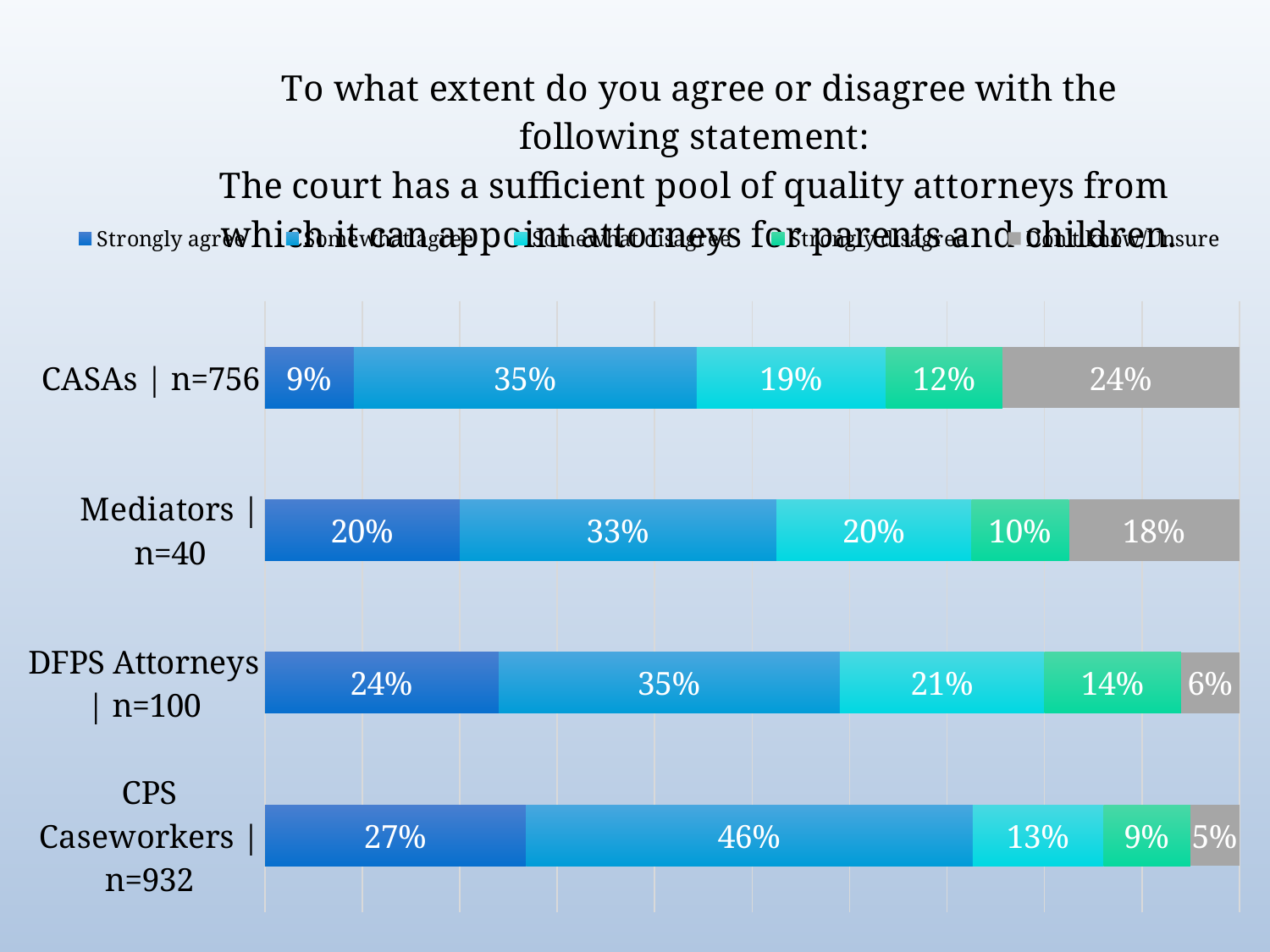
What is the 'Strongly agree' value for CPS Caseworkers | n=932? 27% What is the combined 'Strongly agree' and 'Somewhat agree' value for DFPS Attorneys | n=100? 59% What is the 'Don't know/Unsure' value for CASAs | n=756? 24% Which is larger: the 'Somewhat disagree' value for DFPS Attorneys | n=100 or for CPS Caseworkers | n=932? DFPS Attorneys | n=100 What is the 'Strongly disagree' value for DFPS Attorneys | n=100? 14% How many respondent groups (categories) are shown on the chart? 4 Which group has the highest 'Somewhat agree' value? CPS Caseworkers | n=932 Which group has the lowest 'Strongly agree' value? CASAs | n=756 What kind of chart is shown on the slide? Stacked bar chart How many series does the legend list? 5 What is the difference between the 'Strongly agree' values for CPS Caseworkers | n=932 and CASAs | n=756? 18% What is the 'Somewhat agree' value for Mediators | n=40? 33%